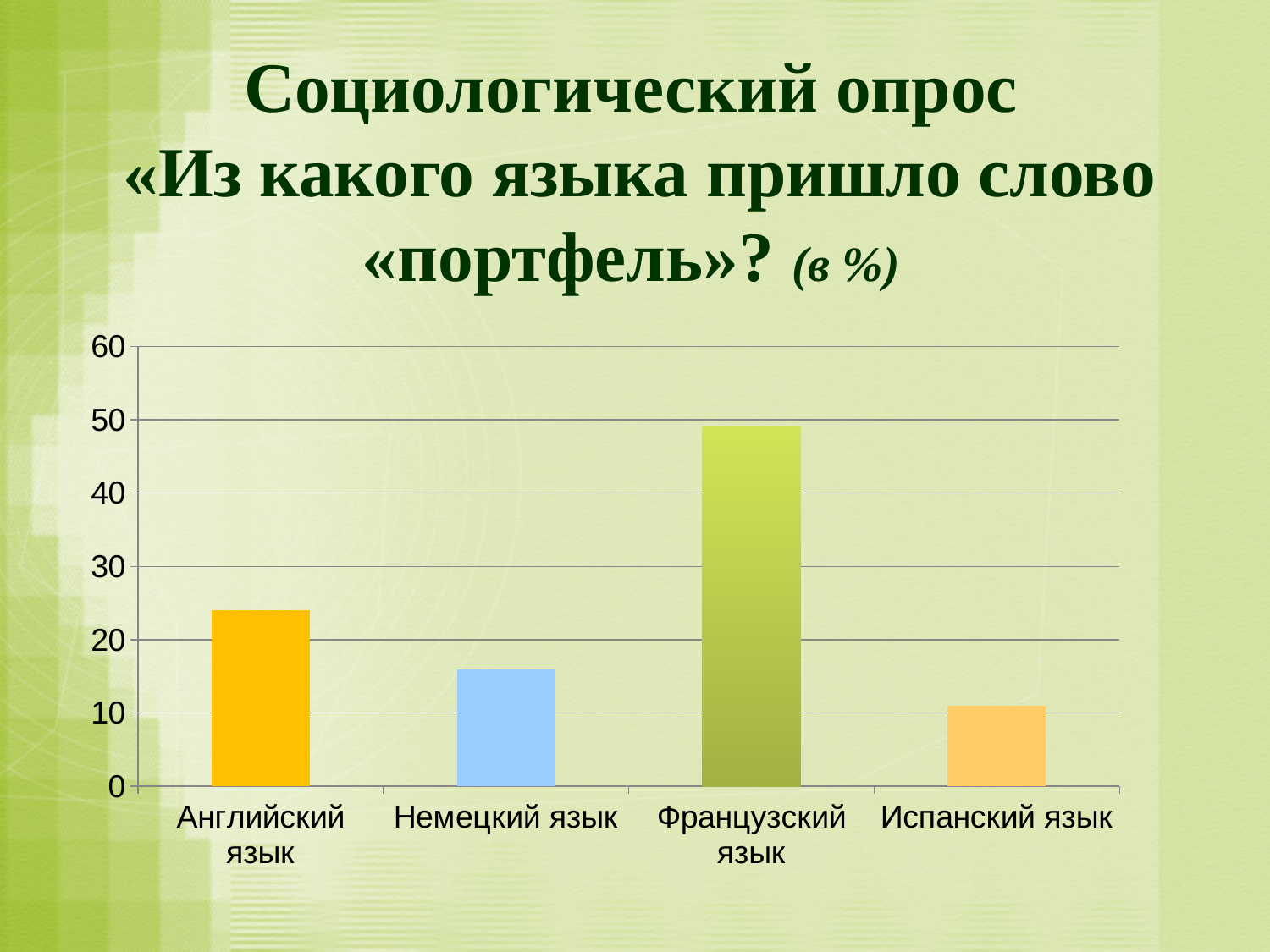
Is the value for Английский язык greater or less than 20? greater Which is larger, the value for Английский язык or the value for Немецкий язык? Английский язык Which language has the highest bar in the chart? Французский язык Which is larger, the value for Немецкий язык or the value for Испанский язык? Немецкий язык Is the value for Французский язык greater or less than 40? greater What is the maximum value shown on the vertical axis of the chart? 60 What kind of chart is shown on the slide? bar chart How many categories (languages) are shown on the x axis of the chart? 4 Is the value for Испанский язык greater or less than 20? less Which language has the lowest bar in the chart? Испанский язык